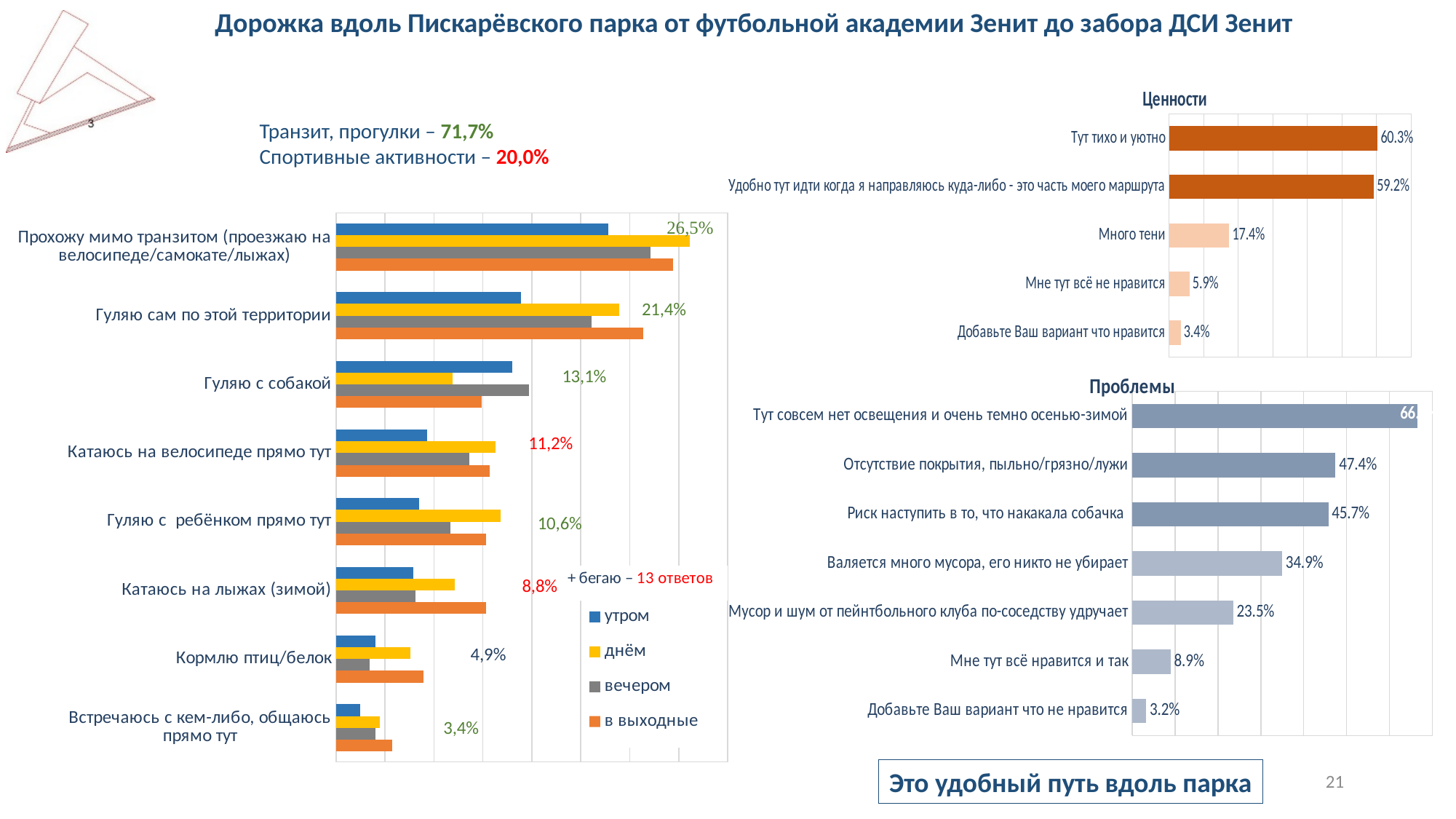
In the 'Проблемы' chart, which category has the highest value? Тут совсем нет освещения и очень темно осенью-зимой In the 'Проблемы' chart, how many categories are shown? 7 In the 'Ценности' chart, what is the value for 'Много тени'? 17.4% In the 'Проблемы' chart, what is the value for 'Валяется много мусора, его никто не убирает'? 34.9% In the left chart, what overall percentage is labelled for 'Гуляю сам по этой территории'? 21,4% What type of chart is the 'Ценности' chart? Bar chart In the 'Ценности' chart, which category has the lowest value? Добавьте Ваш вариант что нравится In the 'Проблемы' chart, which is larger: 'Мусор и шум от пейнтбольного клуба по-соседству удручает' or 'Мне тут всё нравится и так'? Мусор и шум от пейнтбольного клуба по-соседству удручает In the 'Проблемы' chart, what is the value for 'Отсутствие покрытия, пыльно/грязно/лужи'? 47.4% In the 'Ценности' chart, what is the value for 'Тут тихо и уютно'? 60.3% In the left chart, how many series does the legend list? 4 In the 'Ценности' chart, what is the difference between 'Тут тихо и уютно' and 'Мне тут всё не нравится'? 54.4%